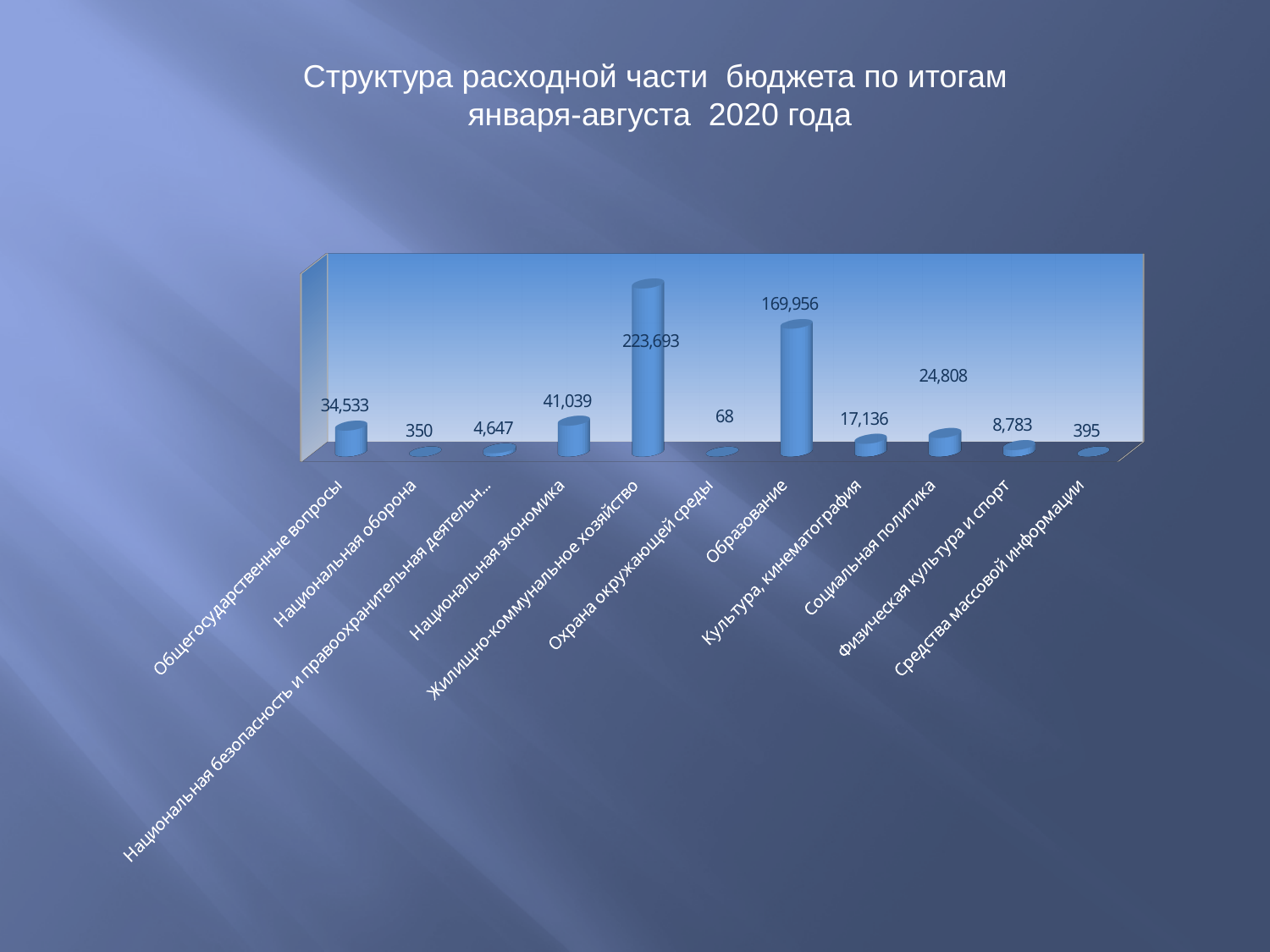
What is the value for Охрана окружающей среды? 68 What kind of chart is shown on the slide? Bar chart Which is larger, the value for Национальная экономика or the value for Общегосударственные вопросы? Национальная экономика What is the value for Образование? 169,956 How many categories are shown in the chart? 11 What is the title of the slide? Структура расходной части бюджета по итогам января-августа 2020 года Which category has the lowest value? Охрана окружающей среды What is the value for Социальная политика? 24,808 Which category has the highest value? Жилищно-коммунальное хозяйство What is the difference between the values for Социальная политика and Культура, кинематография? 7,672 What is the value for Жилищно-коммунальное хозяйство? 223,693 What is the difference between the values for Жилищно-коммунальное хозяйство and Образование? 53,737